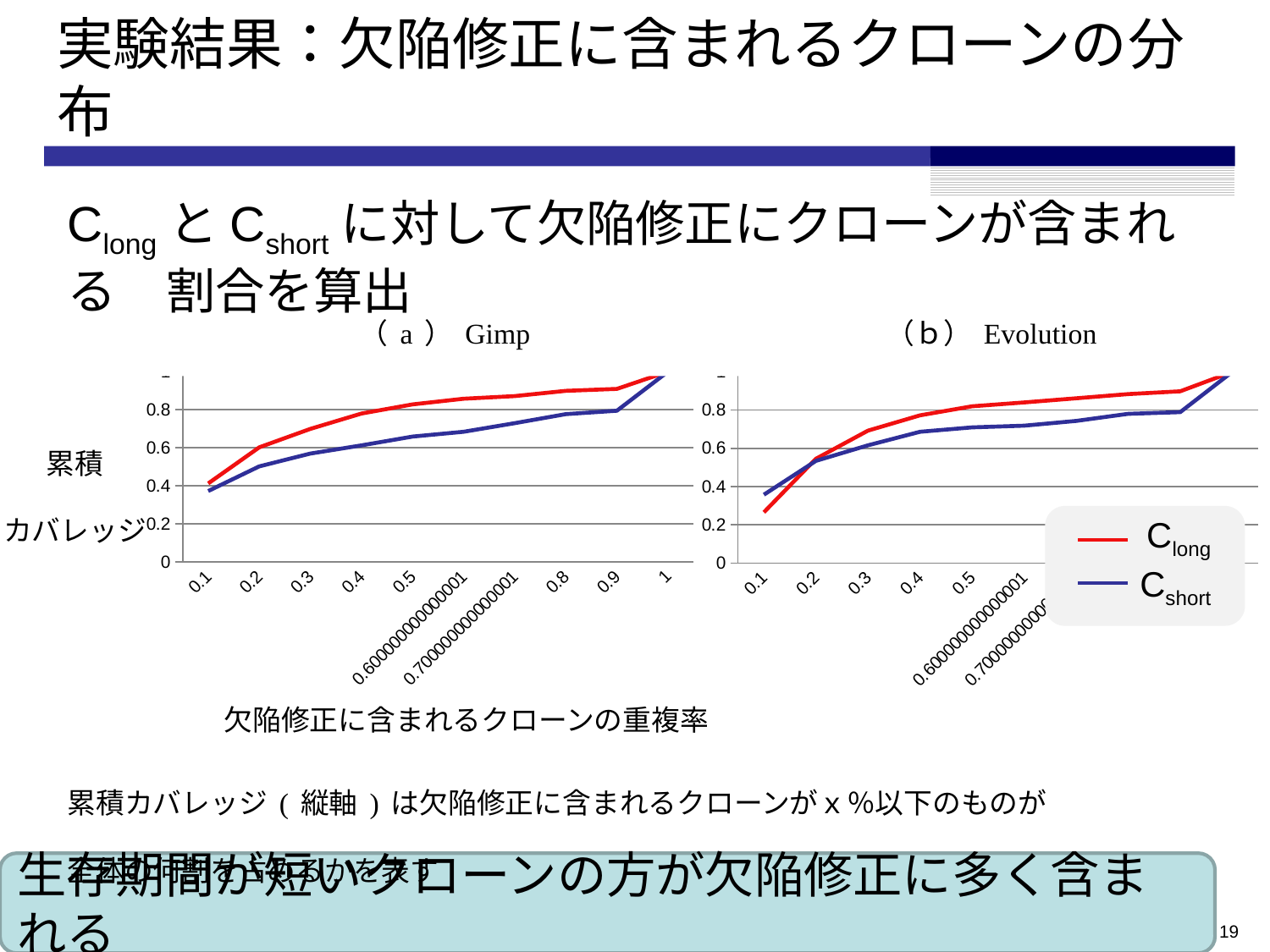
In the (b) Evolution chart, is the value for C_short at 0.5 greater or less than 0.6? greater Which colour is used for the C_long series in the legend? red In the (a) Gimp chart, is the value for C_long at 0.8 greater or less than 0.8? greater In the (b) Evolution chart, do the values of C_short rise or fall as the x axis increases? rise In the (b) Evolution chart, is the value for C_long at 0.1 greater or less than 0.4? less In the (a) Gimp chart, how many x-axis categories are plotted? 10 In the (b) Evolution chart, at x = 0.1, which series has the larger value, C_long or C_short? C_short How many series does the legend list? 2 In the (a) Gimp chart, at x = 0.5, which series has the larger value, C_long or C_short? C_long In the (a) Gimp chart, do the values of C_long rise or fall as the x axis increases? rise What kind of chart is the (a) Gimp chart? line chart